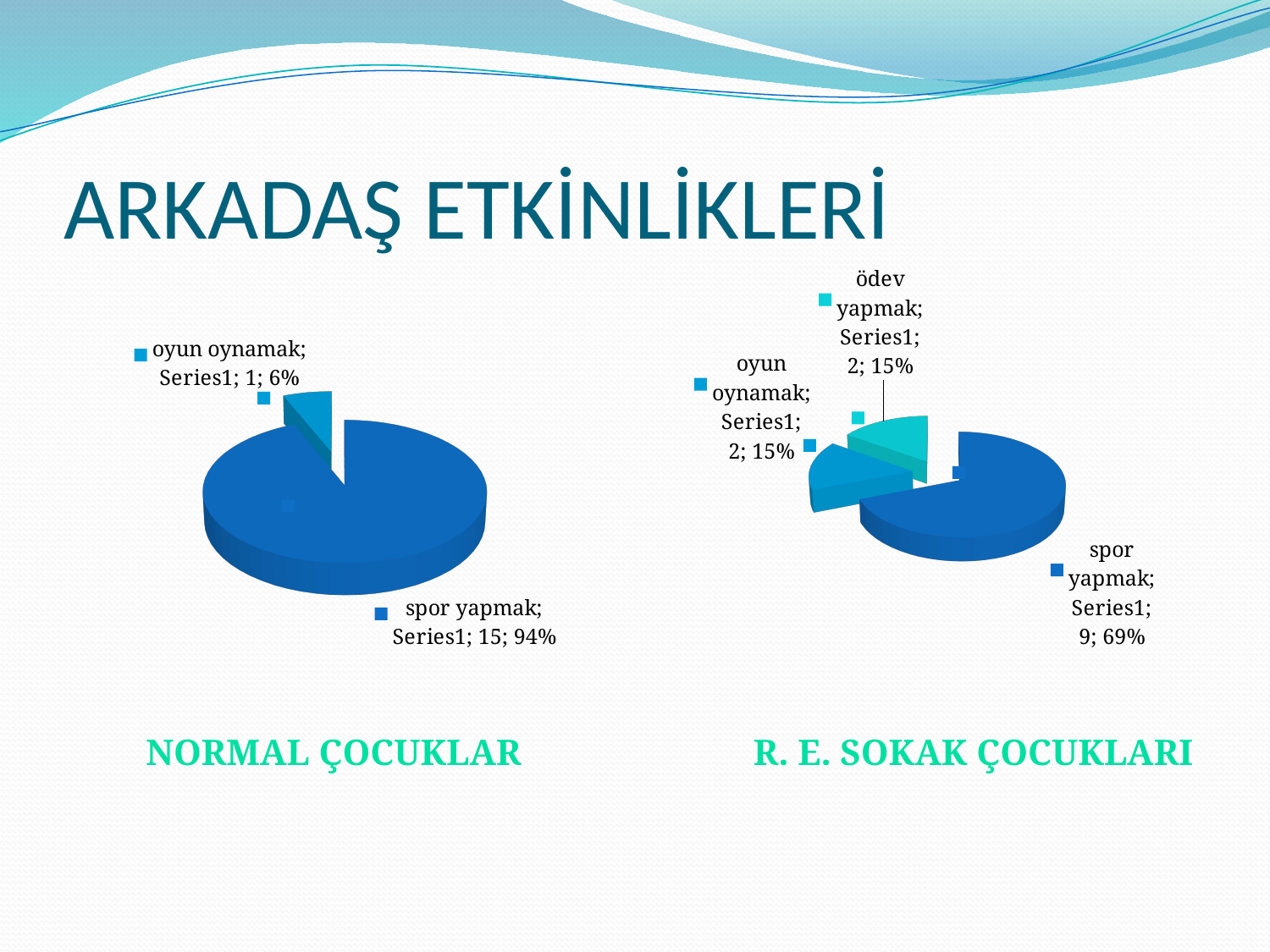
In the NORMAL ÇOCUKLAR chart, what is the value for spor yapmak? 15 In the NORMAL ÇOCUKLAR chart, what share of the pie does spor yapmak have? 94% In the R. E. SOKAK ÇOCUKLARI chart, how many slices does the pie have? 3 In the R. E. SOKAK ÇOCUKLARI chart, which category has the largest slice? spor yapmak In the NORMAL ÇOCUKLAR chart, what is the difference between the values for spor yapmak and oyun oynamak? 14 In the R. E. SOKAK ÇOCUKLARI chart, what is the difference between the values for spor yapmak and oyun oynamak? 7 Which chart has the larger value for spor yapmak, NORMAL ÇOCUKLAR or R. E. SOKAK ÇOCUKLARI? NORMAL ÇOCUKLAR What kind of chart is the NORMAL ÇOCUKLAR chart? pie chart In the R. E. SOKAK ÇOCUKLARI chart, what is the value for spor yapmak? 9 In the R. E. SOKAK ÇOCUKLARI chart, what share of the pie does ödev yapmak have? 15% In the NORMAL ÇOCUKLAR chart, what share of the pie does oyun oynamak have? 6% In the NORMAL ÇOCUKLAR chart, how many slices does the pie have? 2